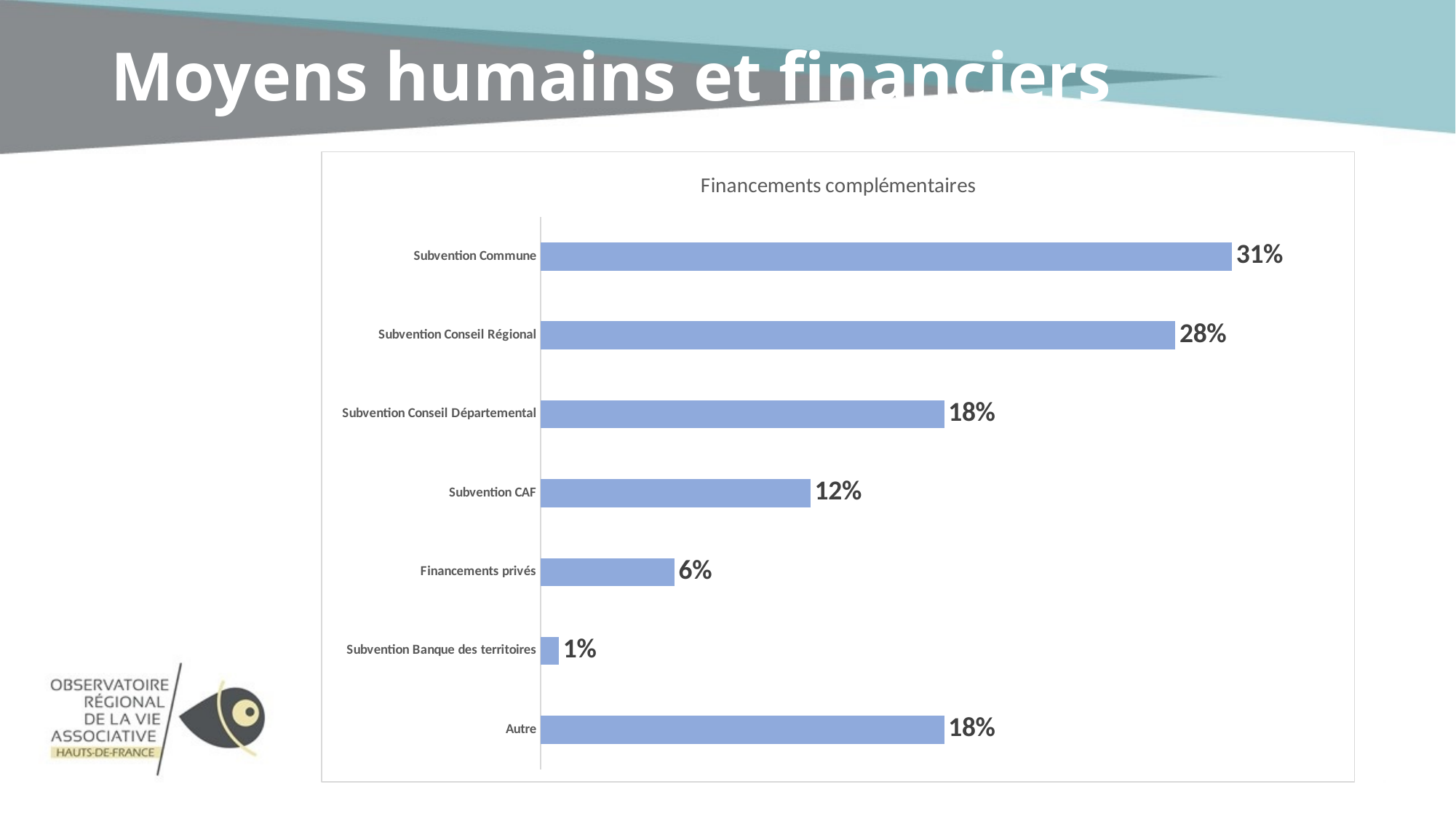
Which category has the lowest value? Subvention Banque des territoires What is the value for Subvention Commune? 31% Which is larger, Subvention CAF or Financements privés? Subvention CAF What is the title of the chart? Financements complémentaires What is the value for Subvention Conseil Régional? 28% What is the difference between Subvention Commune and Subvention Conseil Régional? 3% What is the value for Subvention CAF? 12% How many categories are shown in the chart? 7 What kind of chart is shown on the slide? Bar chart What is the value for Subvention Banque des territoires? 1% Which category has the highest value? Subvention Commune What is the value for Financements privés? 6%